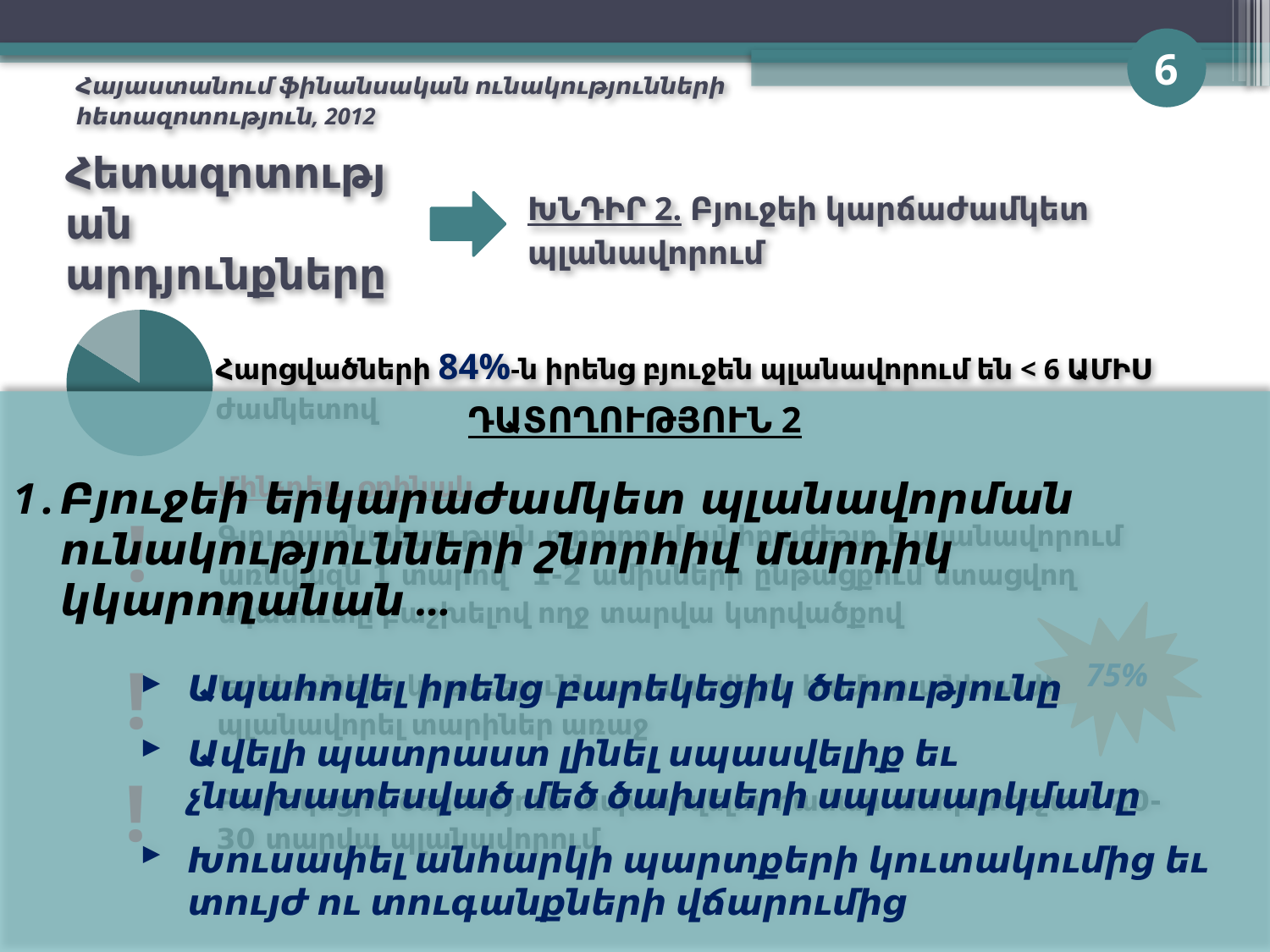
According to the text next to the pie chart, what share of respondents plan their budget for less than 6 months? 84% Which slice of the pie chart is larger, the teal one or the grey one? the teal one Is the larger slice of the pie chart greater or less than 50% of the pie? greater How many slices does the pie chart have? 2 What kind of chart is shown on the left of the slide? pie chart What two colours are used for the slices of the pie chart? teal and grey